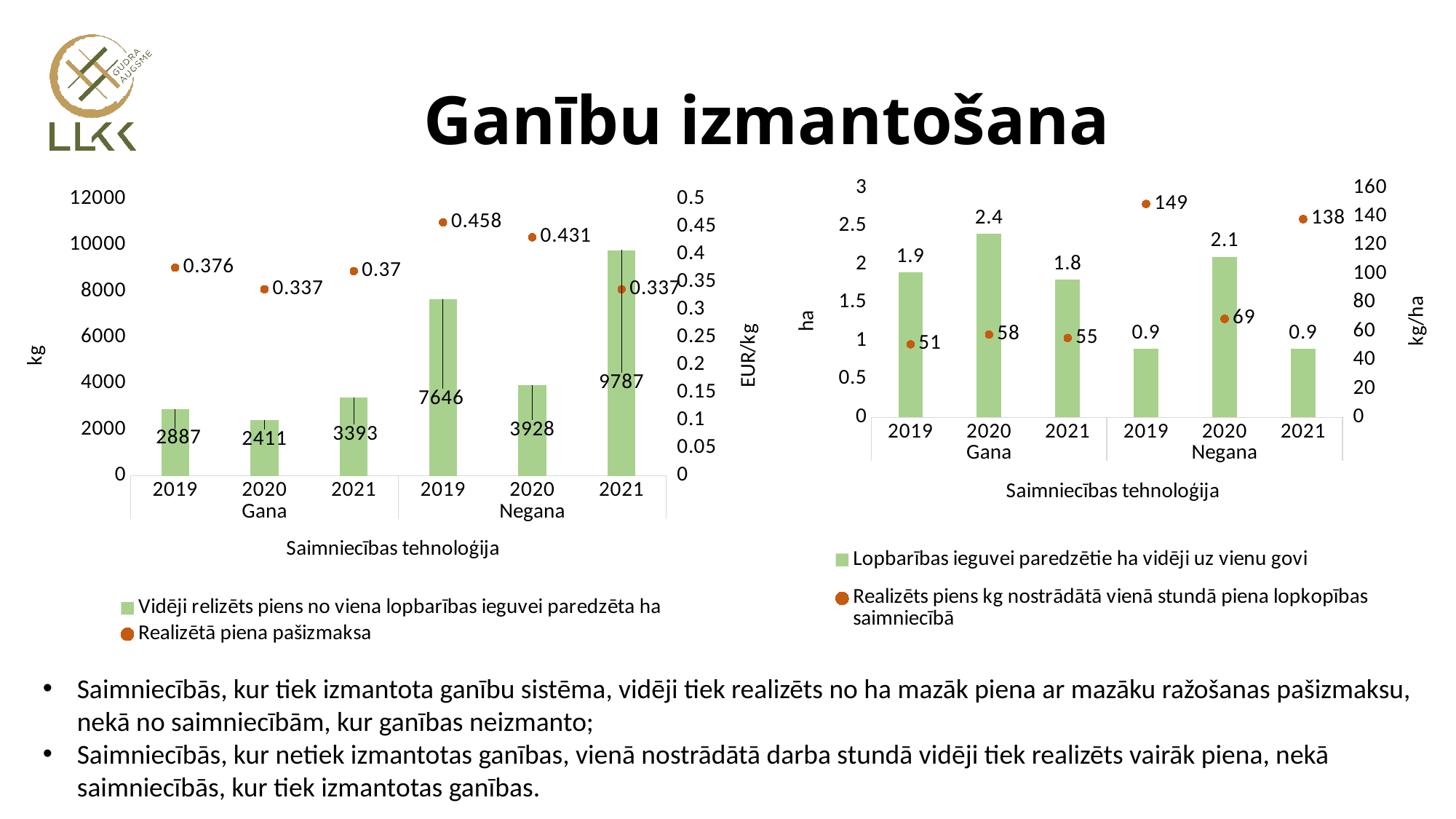
In the left chart, what is the Realizētā piena pašizmaksa value for Negana 2019? 0.458 In the left chart, which category has the lowest bar value? Gana 2020 In the left chart, how many series does the legend list? 2 In the left chart, what is the difference between the bar values for Negana 2021 and Negana 2019? 2141 In the right chart, what is the kg/ha value for Negana 2019? 149 In the right chart, is the kg/ha value for Gana 2020 larger or smaller than the value for Negana 2020? smaller In the left chart, what is the value of the bar for Negana 2021? 9787 In the right chart, how many bars are plotted? 6 In the right chart, what is the ha value for Gana 2020? 2.4 In the left chart, what is the value of the bar for Gana 2019? 2887 In the left chart, which category has the highest bar value? Negana 2021 In the right chart, which category has the highest kg/ha point value? Negana 2019